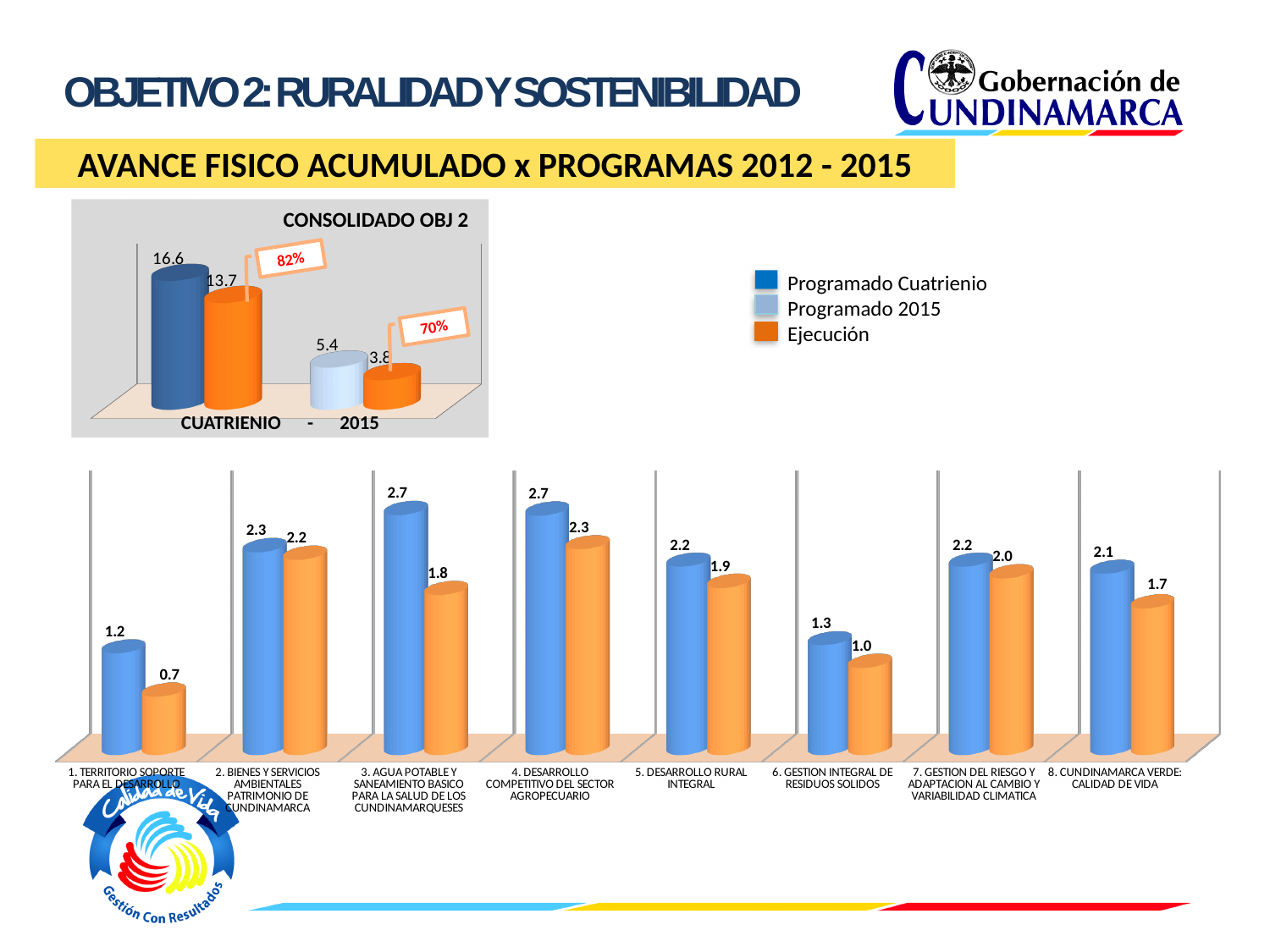
In the CONSOLIDADO OBJ 2 chart, what is the difference between the two bars for CUATRIENIO (16.6 and 13.7)? 2.9 In the bottom chart, what is the value of the orange bar for 1. TERRITORIO SOPORTE PARA EL DESARROLLO? 0.7 In the bottom chart, what is the value of the blue bar for 8. CUNDINAMARCA VERDE: CALIDAD DE VIDA? 2.1 In the bottom chart, which is larger: the orange bar for 4. DESARROLLO COMPETITIVO DEL SECTOR AGROPECUARIO or the orange bar for 6. GESTION INTEGRAL DE RESIDUOS SOLIDOS? 4. DESARROLLO COMPETITIVO DEL SECTOR AGROPECUARIO In the bottom chart, what is the difference between the blue and orange bars for 3. AGUA POTABLE Y SANEAMIENTO BASICO PARA LA SALUD DE LOS CUNDINAMARQUESES? 0.9 In the CONSOLIDADO OBJ 2 chart, what percentage is shown in the callout for CUATRIENIO? 82% In the bottom chart, which program has the lowest blue bar? 1. TERRITORIO SOPORTE PARA EL DESARROLLO How many series does the legend on the slide list? 3 In the CONSOLIDADO OBJ 2 chart, what is the value of the orange bar for 2015? 3.8 What type of chart is the bottom chart? Bar chart How many programs (categories) are shown in the bottom chart? 8 In the CONSOLIDADO OBJ 2 chart, what is the value of the dark blue bar for CUATRIENIO? 16.6